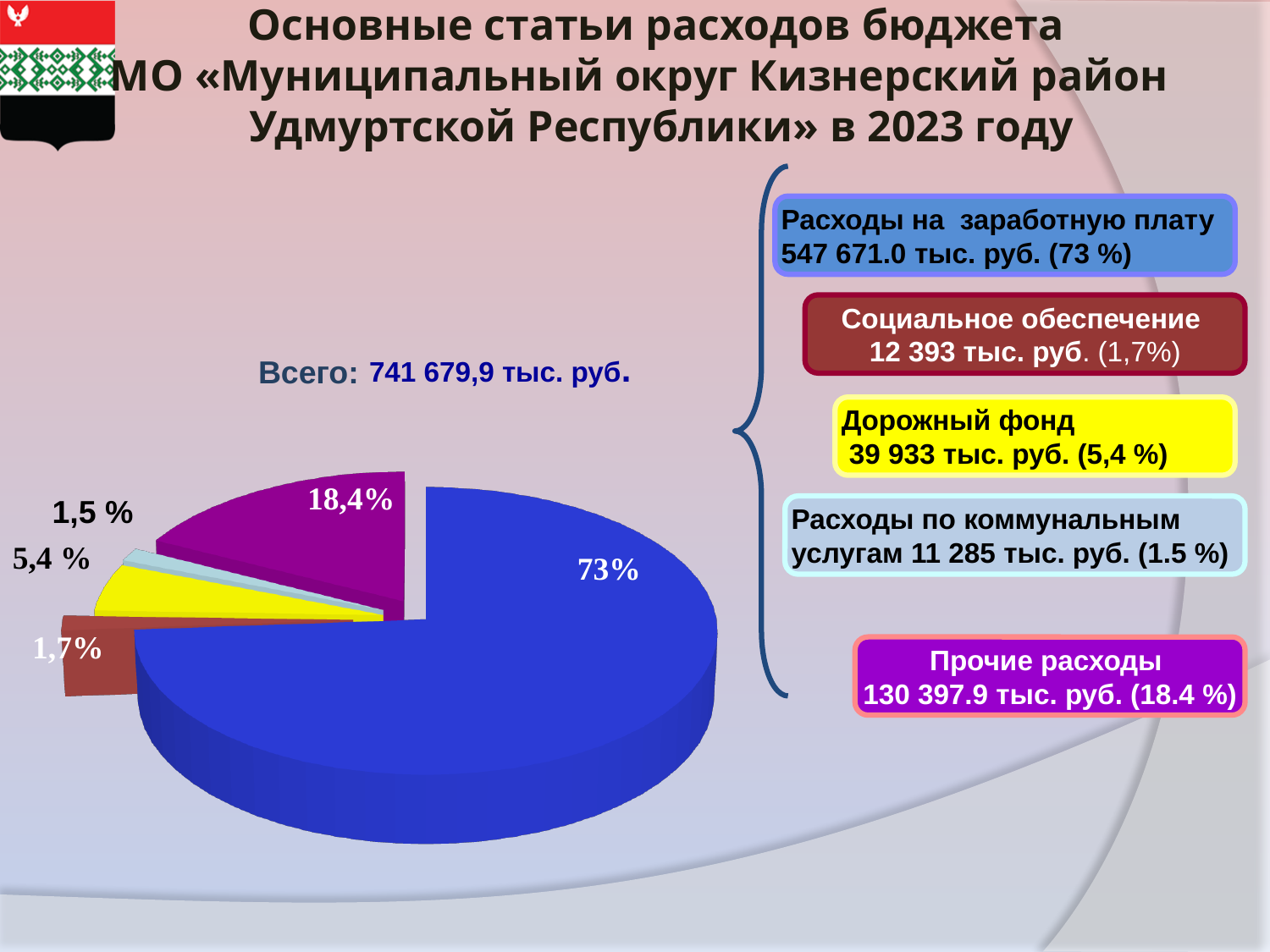
How many slices does the pie chart have? 5 What is the total (Всего) amount shown for the budget expenditures? 741 679,9 тыс. руб. Which has the larger share: Дорожный фонд or Социальное обеспечение? Дорожный фонд What colour is the largest slice of the pie? blue What is the amount shown for Социальное обеспечение? 12 393 тыс. руб. By how many percentage points does the share for Расходы на заработную плату exceed the share for Прочие расходы? 54,6 Which expenditure item has the largest share of the pie? Расходы на заработную плату What share of the pie does Дорожный фонд take? 5,4 % What kind of chart is shown on the slide? pie chart Which expenditure item has the smallest share of the pie? Расходы по коммунальным услугам What share of the pie is labelled for Прочие расходы? 18,4% What is the amount shown for Прочие расходы? 130 397.9 тыс. руб.